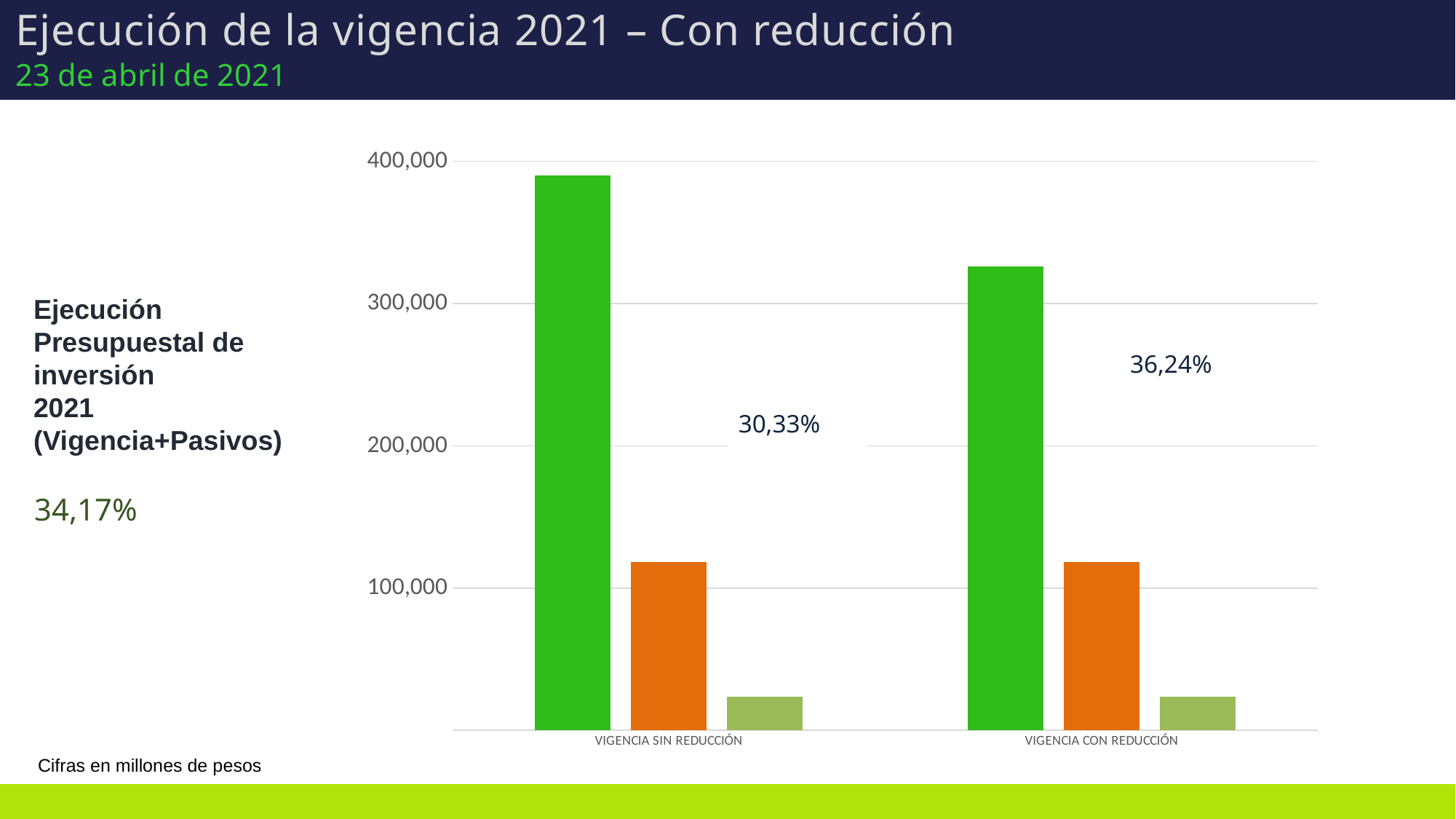
What percentage is annotated next to the VIGENCIA CON REDUCCIÓN bars? 36,24% What percentage is annotated next to the VIGENCIA SIN REDUCCIÓN bars? 30,33% What is the highest value shown on the chart's vertical axis? 400,000 How many categories are shown on the x axis of the chart? 2 Within the VIGENCIA SIN REDUCCIÓN category, which bar colour is the shortest? light green What kind of chart is shown on the slide? bar chart How many bars are plotted for each category in the chart? 3 Is the value of the tallest (green) bar for VIGENCIA SIN REDUCCIÓN greater or less than 300,000? greater Is the value of the light green bar for VIGENCIA CON REDUCCIÓN greater or less than 100,000? less Which category has the taller green bar, VIGENCIA SIN REDUCCIÓN or VIGENCIA CON REDUCCIÓN? VIGENCIA SIN REDUCCIÓN Is the value of the tallest (green) bar for VIGENCIA CON REDUCCIÓN greater or less than 400,000? less